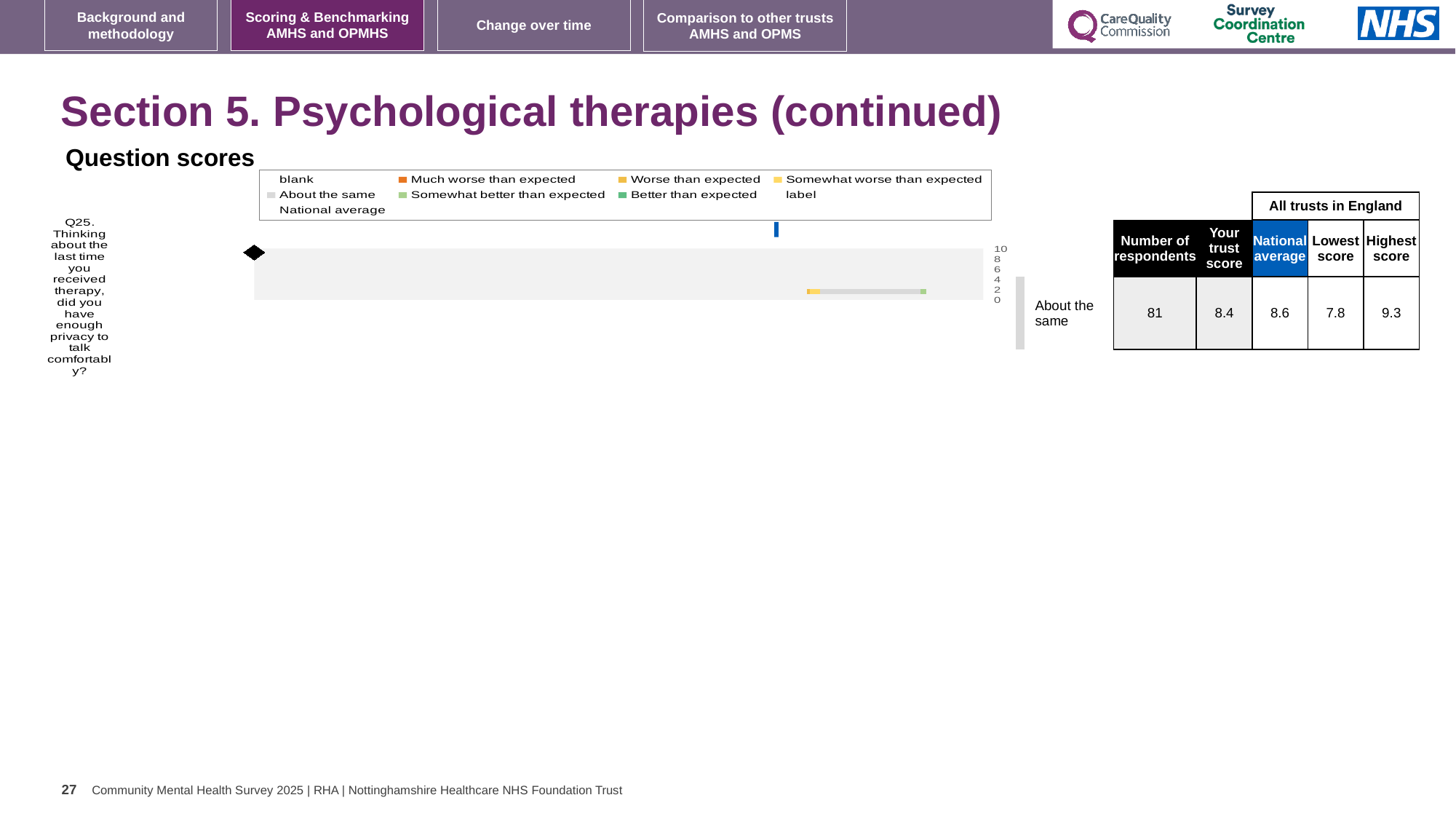
According to the table next to the chart, what is your trust score for Q25? 8.4 What is the highest value shown on the chart's axis? 10 According to the table next to the chart, what is the national average for Q25? 8.6 What benchmark category label is shown to the right of the chart for Q25? About the same What kind of chart is shown on the slide? bar chart Which survey question is plotted in the chart? Q25. Thinking about the last time you received therapy, did you have enough privacy to talk comfortably? According to the table next to the chart, what is the highest score among all trusts in England for Q25? 9.3 Is your trust score for Q25 larger or smaller than the national average? smaller According to the table next to the chart, what is the number of respondents for Q25? 81 How many survey questions are plotted in the chart? 1 How many entries does the chart legend list? 9 According to the table next to the chart, what is the lowest score among all trusts in England for Q25? 7.8